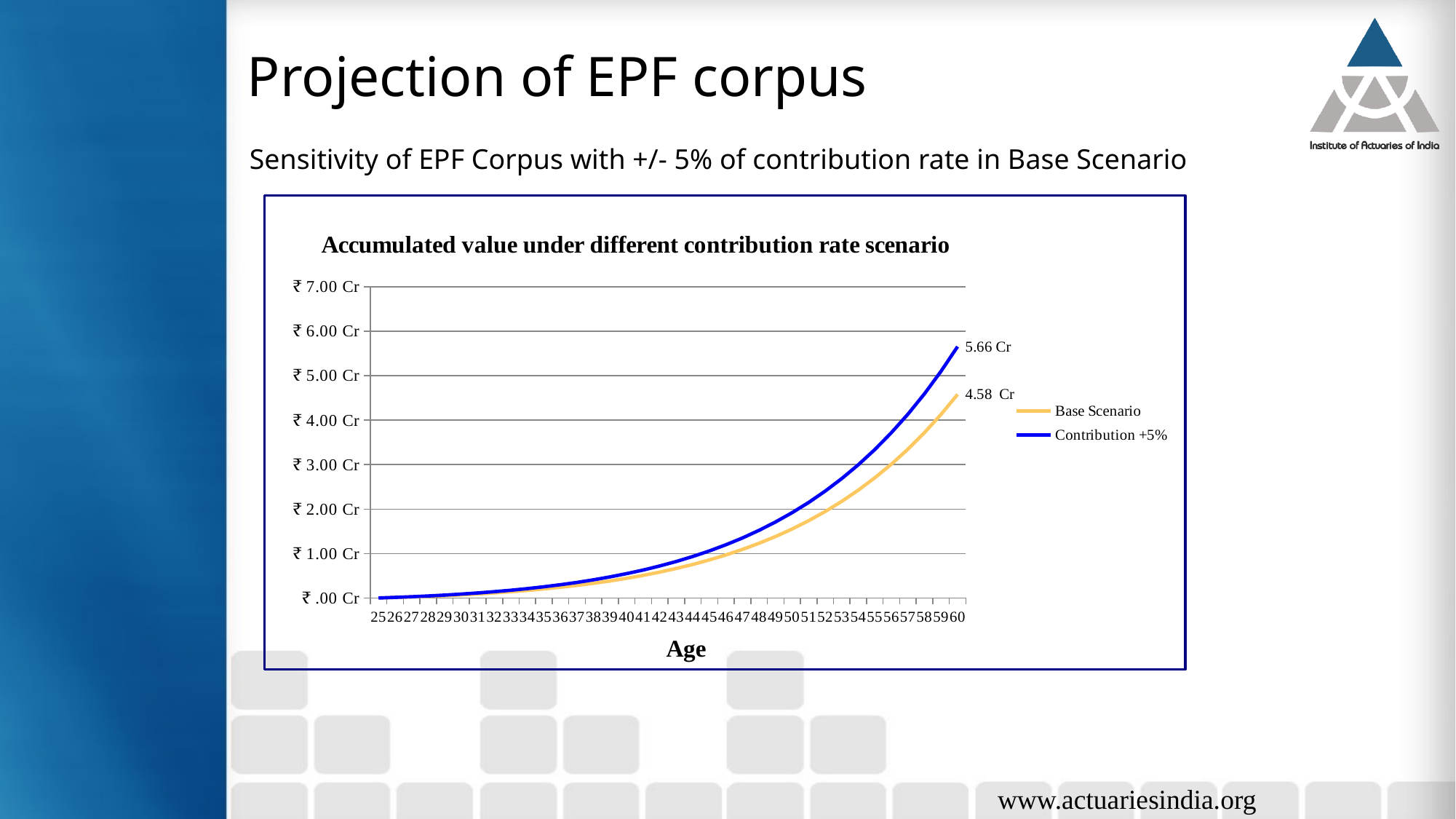
What is the value of the Base Scenario series at age 60? 4.58 Cr Is the Contribution +5% value at age 58 greater or less than ₹ 3.00 Cr? greater What kind of chart is shown on the slide? line chart How many series does the legend list? 2 How many ages are shown on the x axis? 36 Do the accumulated values rise or fall as age increases? rise At age 60, which series has the higher accumulated value, Base Scenario or Contribution +5%? Contribution +5% What is the difference between the Contribution +5% and Base Scenario values at age 60? 1.08 Cr What is the value of the Contribution +5% series at age 60? 5.66 Cr What is the title of the chart? Accumulated value under different contribution rate scenario Is the Base Scenario value at age 50 greater or less than ₹ 3.00 Cr? less Is the Contribution +5% value at age 40 greater or less than ₹ 1.00 Cr? less